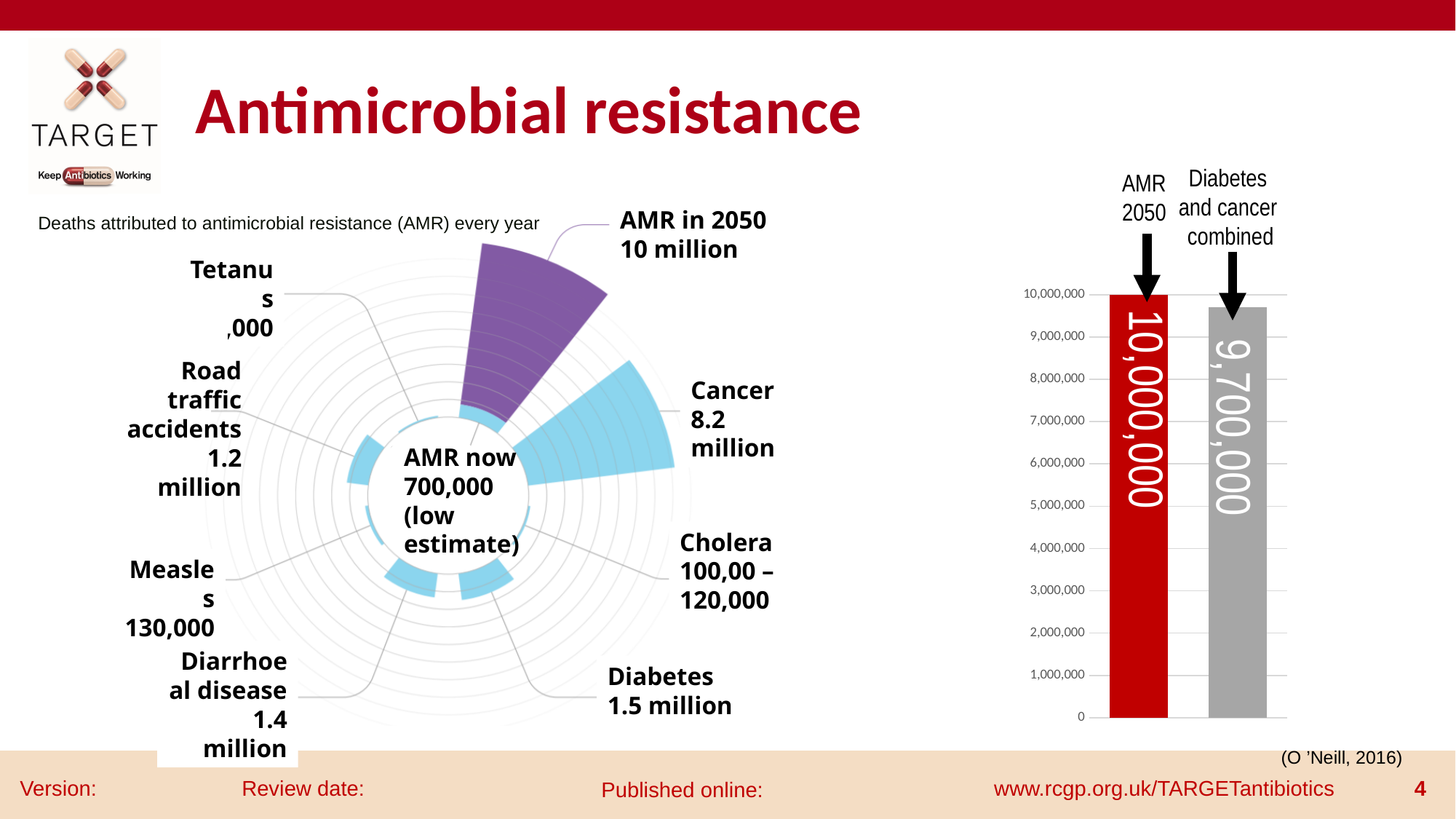
In the radial chart on the left, which segment is larger: Diabetes or Diarrhoeal disease? Diabetes How many bars are shown in the bar chart on the right? 2 In the radial chart on the left, what is the value for AMR now (low estimate)? 700,000 In the bar chart on the right, what is the value for AMR 2050? 10,000,000 In the radial chart on the left, what is the value for Road traffic accidents? 1.2 million What kind of chart is shown on the right side of the slide? Bar chart In the radial chart on the left, what is the value for Diabetes? 1.5 million In the bar chart on the right, which bar is taller: AMR 2050 or Diabetes and cancer combined? AMR 2050 In the radial chart on the left (deaths attributed to AMR every year), what is the value for Cancer? 8.2 million In the radial chart on the left, what is the value for Measles? 130,000 In the bar chart on the right, what is the value for Diabetes and cancer combined? 9,700,000 In the bar chart on the right, what is the difference between the AMR 2050 bar and the Diabetes and cancer combined bar? 300,000